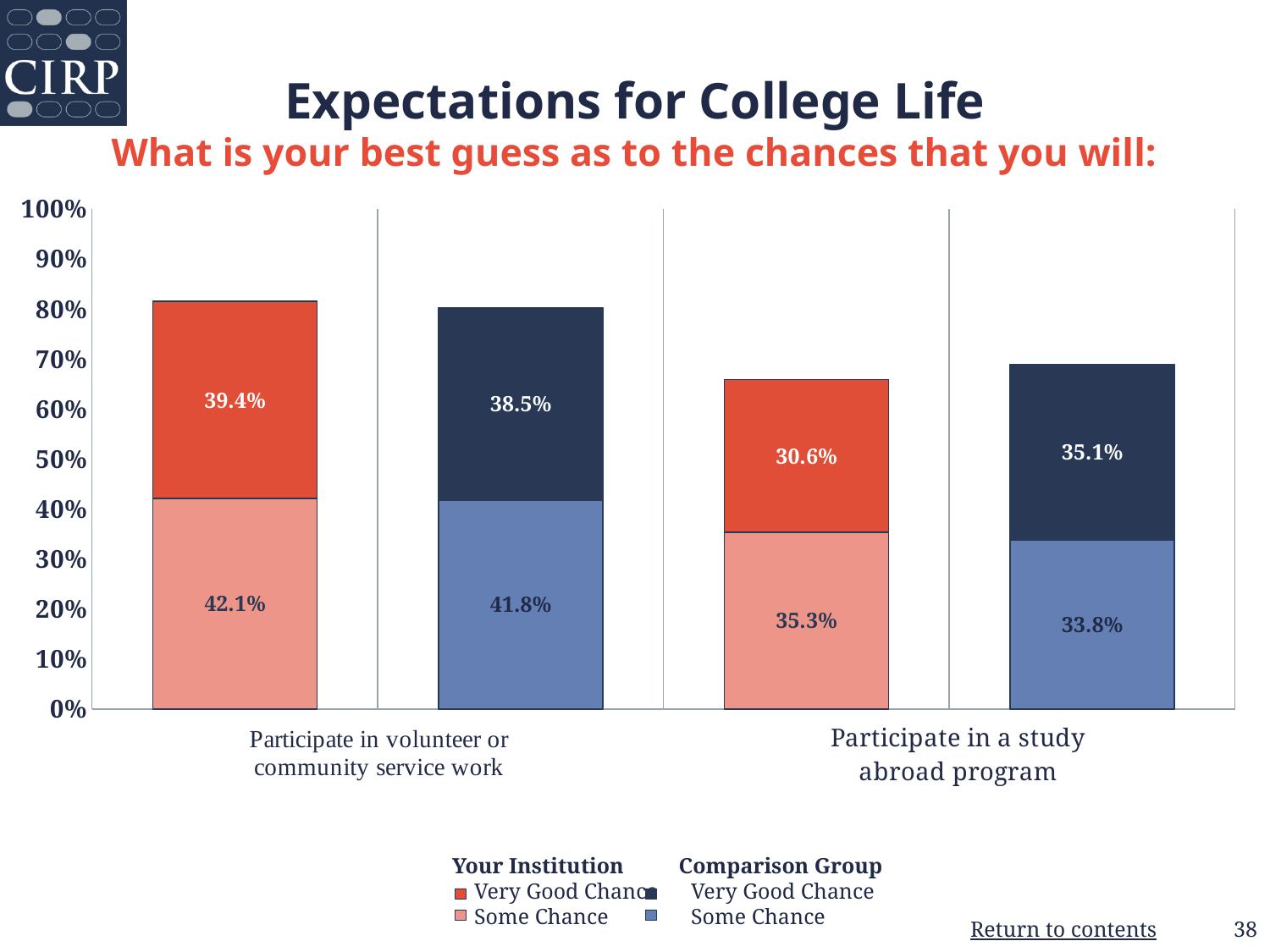
What kind of chart is shown on the slide? Stacked bar chart What is the total stacked value for Your Institution for participating in volunteer or community service work? 81.5% What percentage of Your Institution students said there is a Very Good Chance they will participate in volunteer or community service work? 39.4% What is the total stacked value for the Comparison Group for participating in a study abroad program? 68.9% How many series does the legend list? 4 What percentage of Your Institution students said there is Some Chance they will participate in a study abroad program? 35.3% What is the difference between Your Institution's and the Comparison Group's Very Good Chance values for participating in a study abroad program? 4.5% For participating in volunteer or community service work, which is larger: Your Institution's Some Chance value or the Comparison Group's Some Chance value? Your Institution's Some Chance value What percentage of the Comparison Group said there is Some Chance they will participate in a study abroad program? 33.8% What is the Comparison Group's Very Good Chance value for participating in volunteer or community service work? 38.5% Which of the two activities has the lower Very Good Chance value for Your Institution? Participate in a study abroad program How many activity categories are shown on the x axis? 2